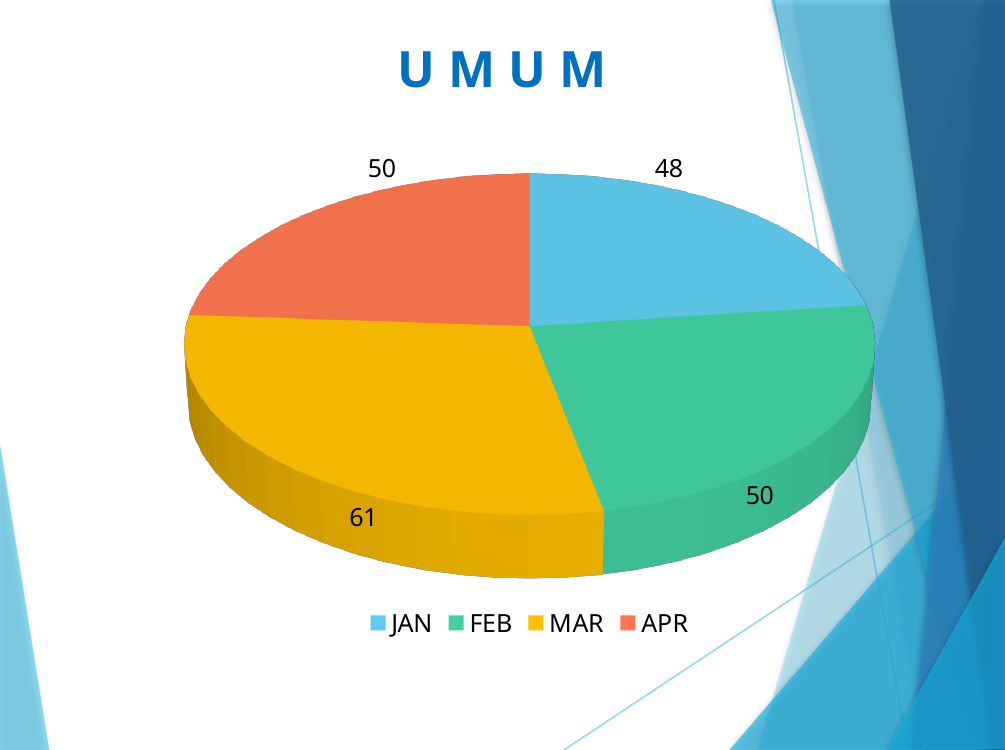
What is the value for APR? 50 How many slices does the pie chart have? 4 What kind of chart is shown on the slide? pie chart Which month has the smallest slice? JAN What is the total of all four slices? 209 What is the difference between the values for MAR and JAN? 13 Which is larger, the value for JAN or the value for FEB? FEB What is the value for JAN? 48 Which month has the largest slice? MAR What is the value for MAR? 61 What is the title of the chart? UMUM What is the value for FEB? 50